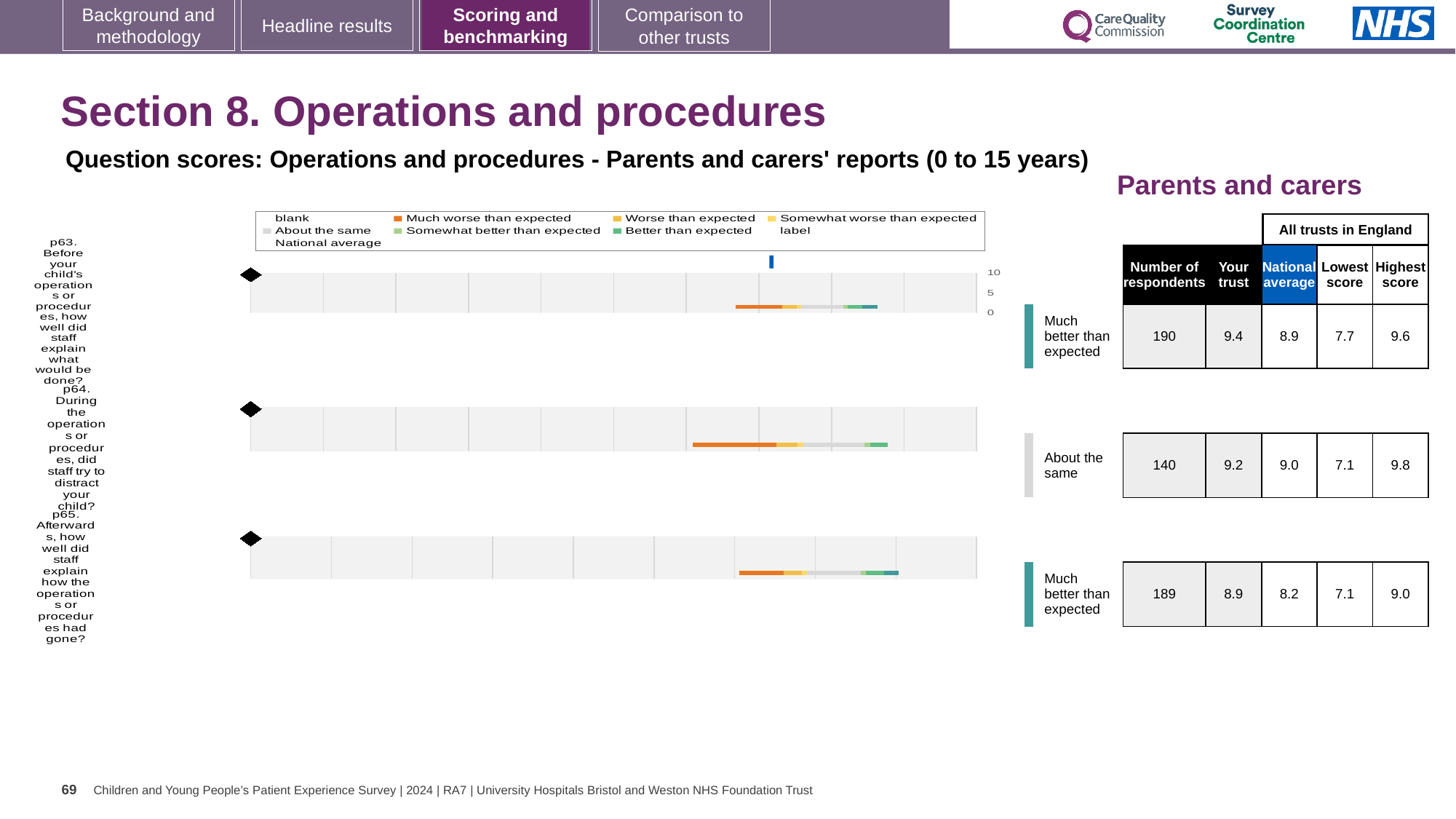
How many questions (categories) are plotted in the chart? 3 For question p63, what is the difference between the 'Your trust' score and the national average? 0.5 What is the national average score for question p65 (Afterwards, how well did staff explain how the operations or procedures had gone?)? 8.2 Which question has the highest 'Your trust' score? p63 Which question has the lowest national average score? p65 What benchmark label is shown next to question p64? About the same What is the number of respondents for question p63 (Before your child's operations or procedures, how well did staff explain what would be done?)? 190 What is the 'Your trust' score for question p64 (During the operations or procedures, did staff try to distract your child?)? 9.2 What kind of chart is shown on the slide? bar chart For question p64, which is larger: the 'Your trust' score or the national average? Your trust What is the highest score across all trusts in England for question p64? 9.8 What is the lowest score across all trusts in England for question p63? 7.7